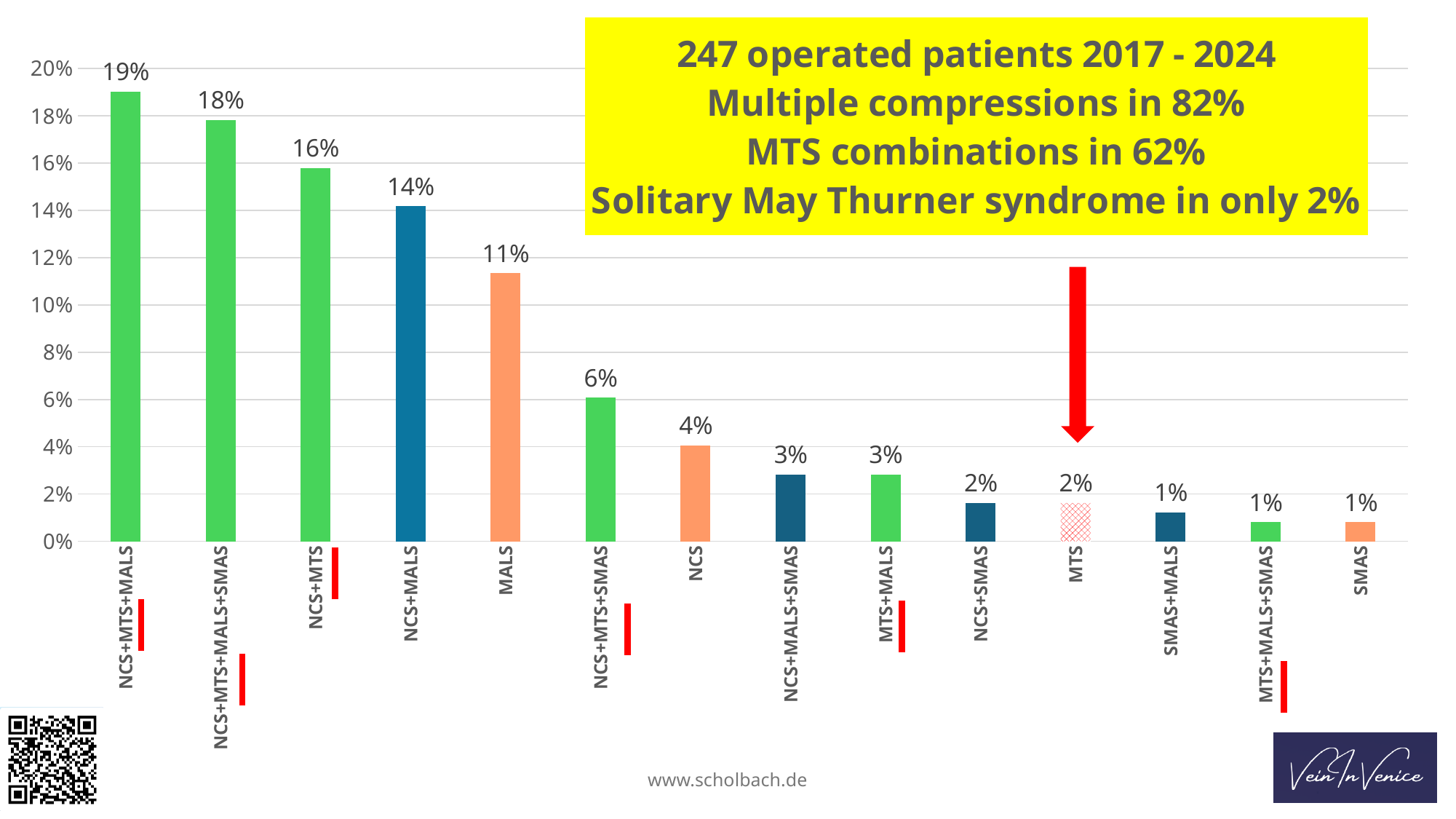
What is the difference between the values for NCS+MTS+MALS and NCS+MALS? 5% What is the value for MTS? 2% Do the values rise or fall from left to right along the x axis? fall What is the difference between the values for NCS+MTS and NCS? 12% What is the value for NCS+MTS+MALS? 19% What is the value for NCS+MALS? 14% What is the value for MALS? 11% How many categories are shown on the x axis? 14 Which category has the highest value? NCS+MTS+MALS What is the value for NCS+MTS+SMAS? 6% Which is larger, the value for MALS or the value for NCS? MALS What kind of chart is shown on the slide? bar chart